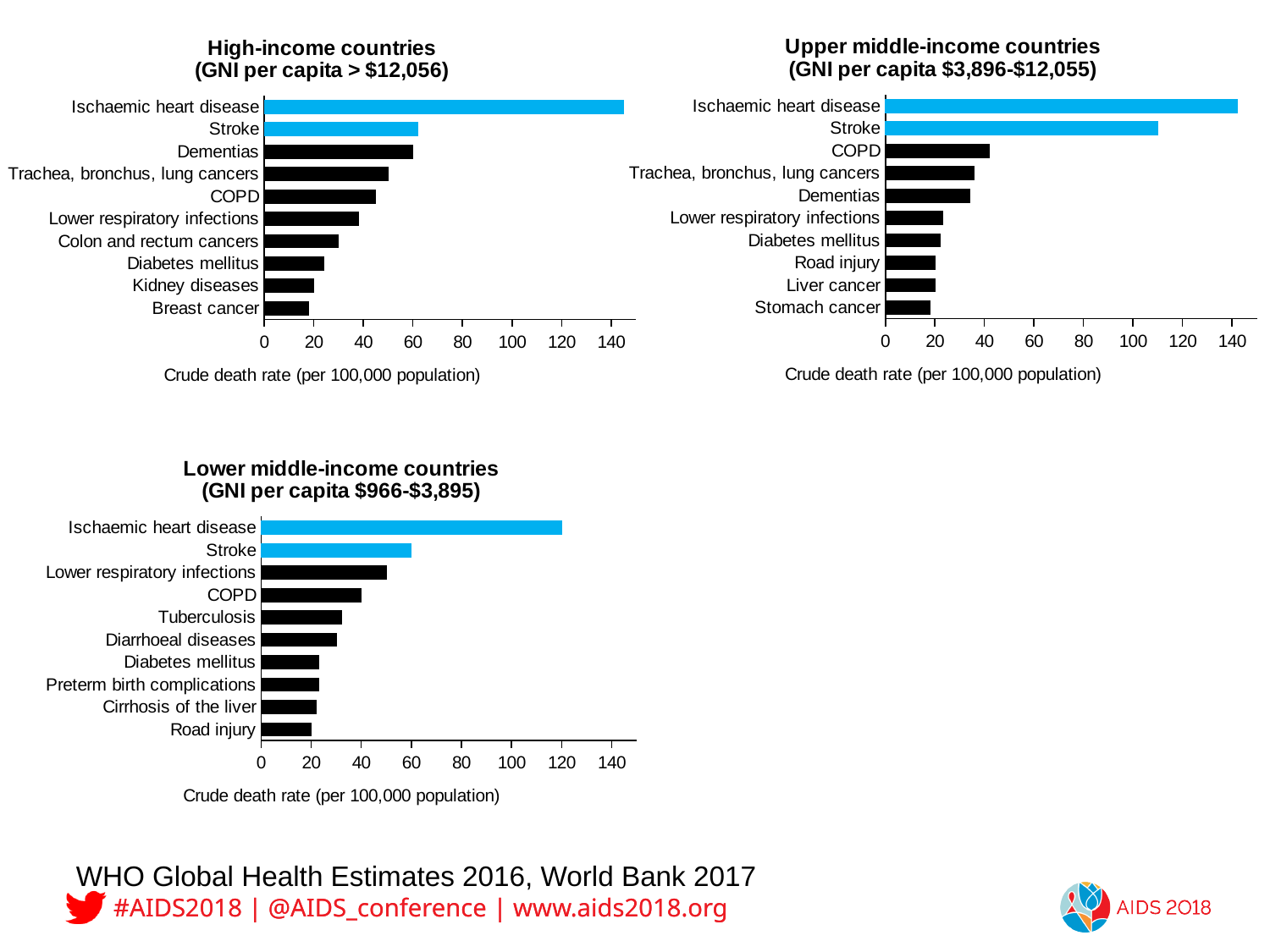
How many causes of death are listed in the Lower middle-income countries chart? 10 In the Lower middle-income countries chart, which cause has the highest crude death rate? Ischaemic heart disease In the Lower middle-income countries chart, is the value for Ischaemic heart disease greater or less than 100? greater In the High-income countries chart, which cause has the lowest crude death rate? Breast cancer In the High-income countries chart, is the value for Ischaemic heart disease greater or less than 140? greater What kind of chart is the High-income countries chart? Bar chart In the Upper middle-income countries chart, is the value for Stroke greater or less than 100? greater In the High-income countries chart, which cause has the highest crude death rate? Ischaemic heart disease In the Upper middle-income countries chart, which cause has the lowest crude death rate? Stomach cancer In the Upper middle-income countries chart, which is larger, the value for COPD or the value for Lower respiratory infections? COPD In the Lower middle-income countries chart, which is larger, the value for Lower respiratory infections or the value for Tuberculosis? Lower respiratory infections